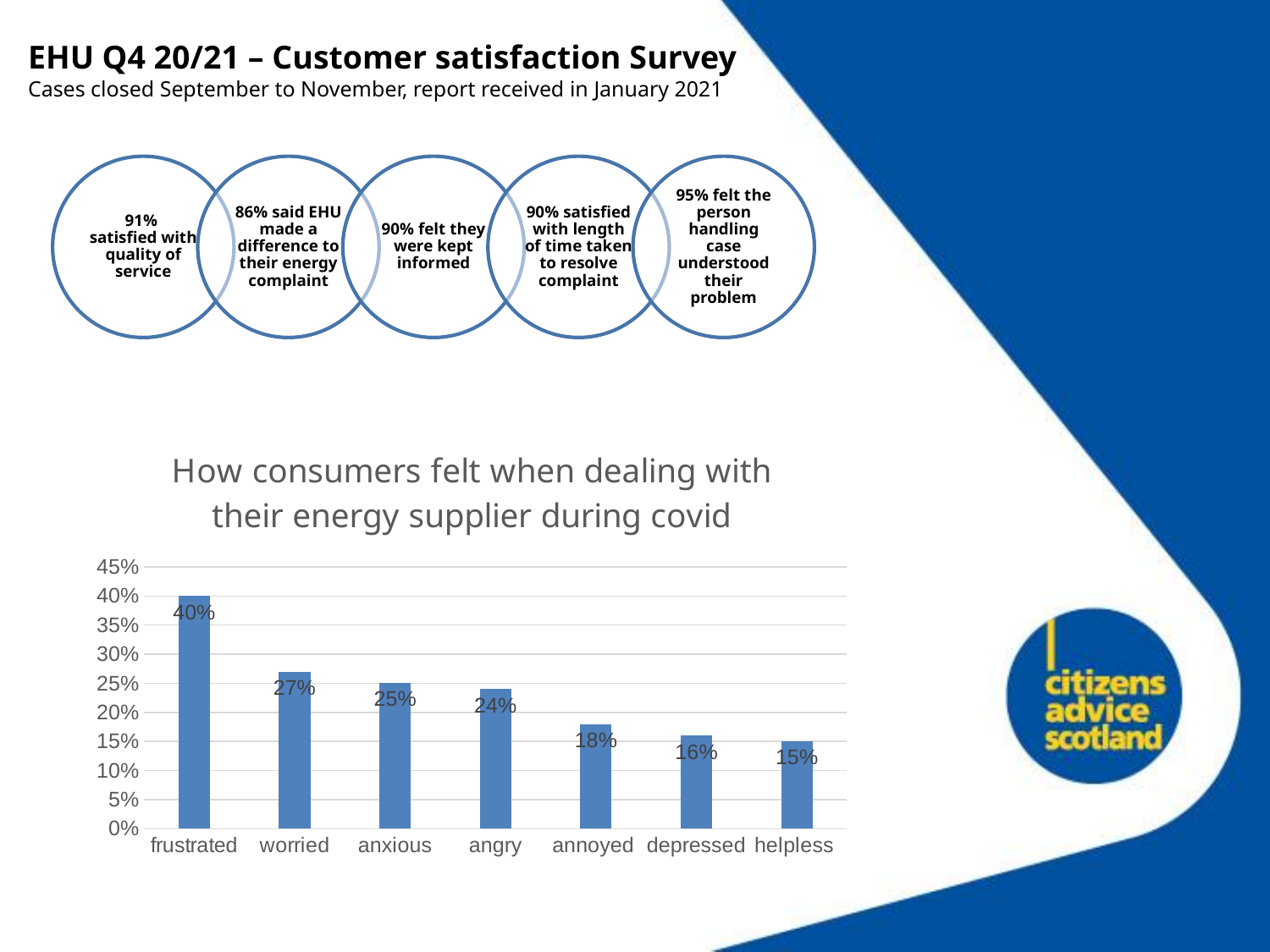
What is the value shown for 'depressed' in the chart? 16% What kind of chart is used to show how consumers felt when dealing with their energy supplier? bar chart What is the difference between the percentages for 'anxious' and 'helpless'? 10% What is the title of the chart on the slide? How consumers felt when dealing with their energy supplier during covid Which is larger, the value for 'worried' or the value for 'angry'? worried How many feelings (categories) are shown on the x axis of the chart? 7 What is the value shown for 'annoyed' in the chart? 18% Which feeling has the highest percentage in the chart? frustrated What is the difference between the percentages for 'frustrated' and 'worried'? 13% Is the value for 'annoyed' greater or less than 20%? less What percentage of consumers felt frustrated when dealing with their energy supplier during covid? 40% Which feeling has the lowest percentage in the chart? helpless